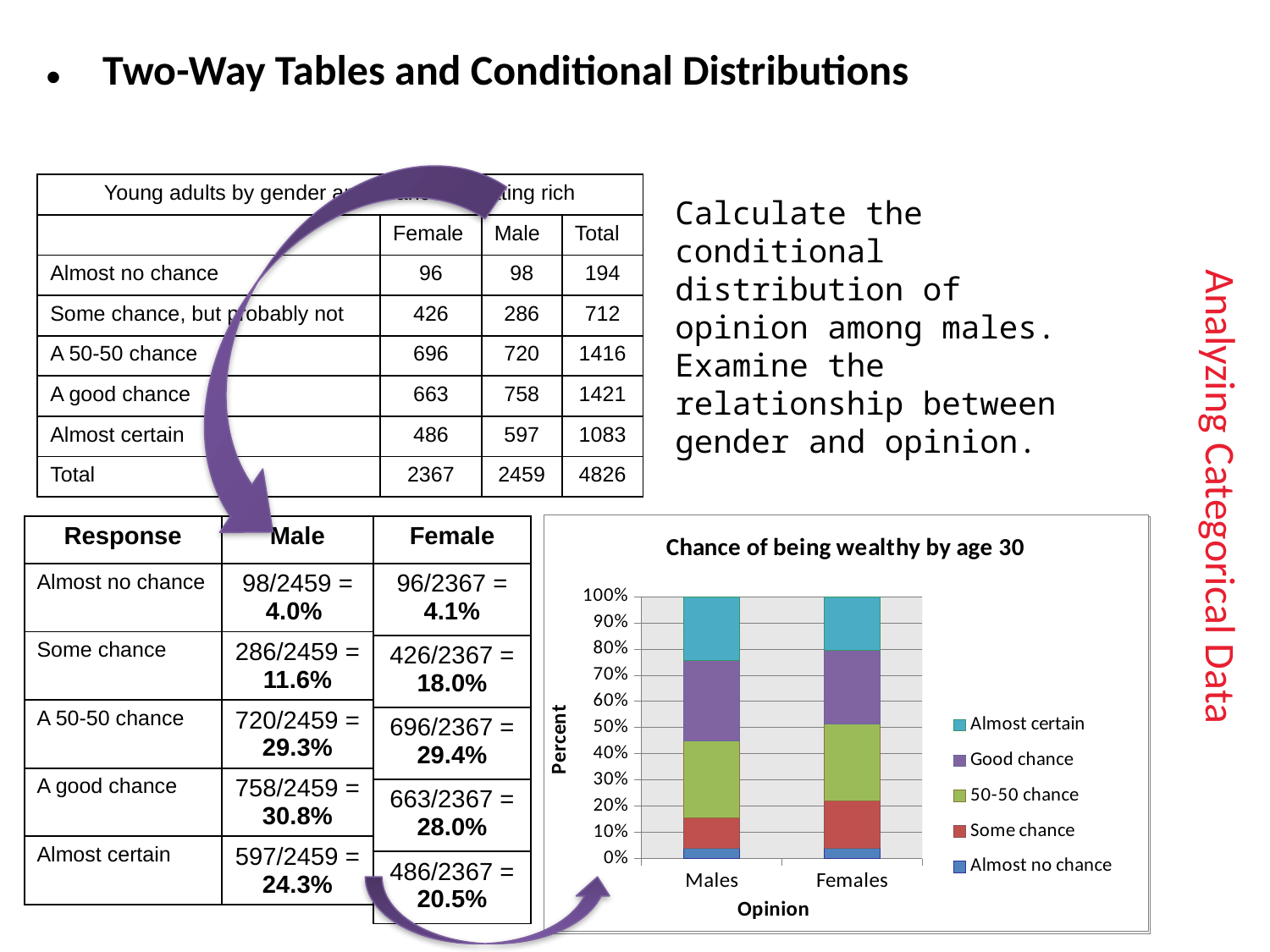
Is the top of the Some chance segment in the Males bar greater or less than 20%? less What is the total height of the Males stacked bar? 100% How many series does the chart's legend list? 5 Which category has the larger Almost certain segment, Males or Females? Males Is the top of the Good chance segment in the Males bar greater or less than 70%? greater Which category has the larger Some chance segment, Males or Females? Females Is the top of the 50-50 chance segment in the Males bar greater or less than 50%? less What is the title of the chart on the slide? Chance of being wealthy by age 30 What is the label of the y axis of the chart? Percent How many categories are shown on the x axis of the chart? 2 What type of chart is shown on the slide? stacked bar chart